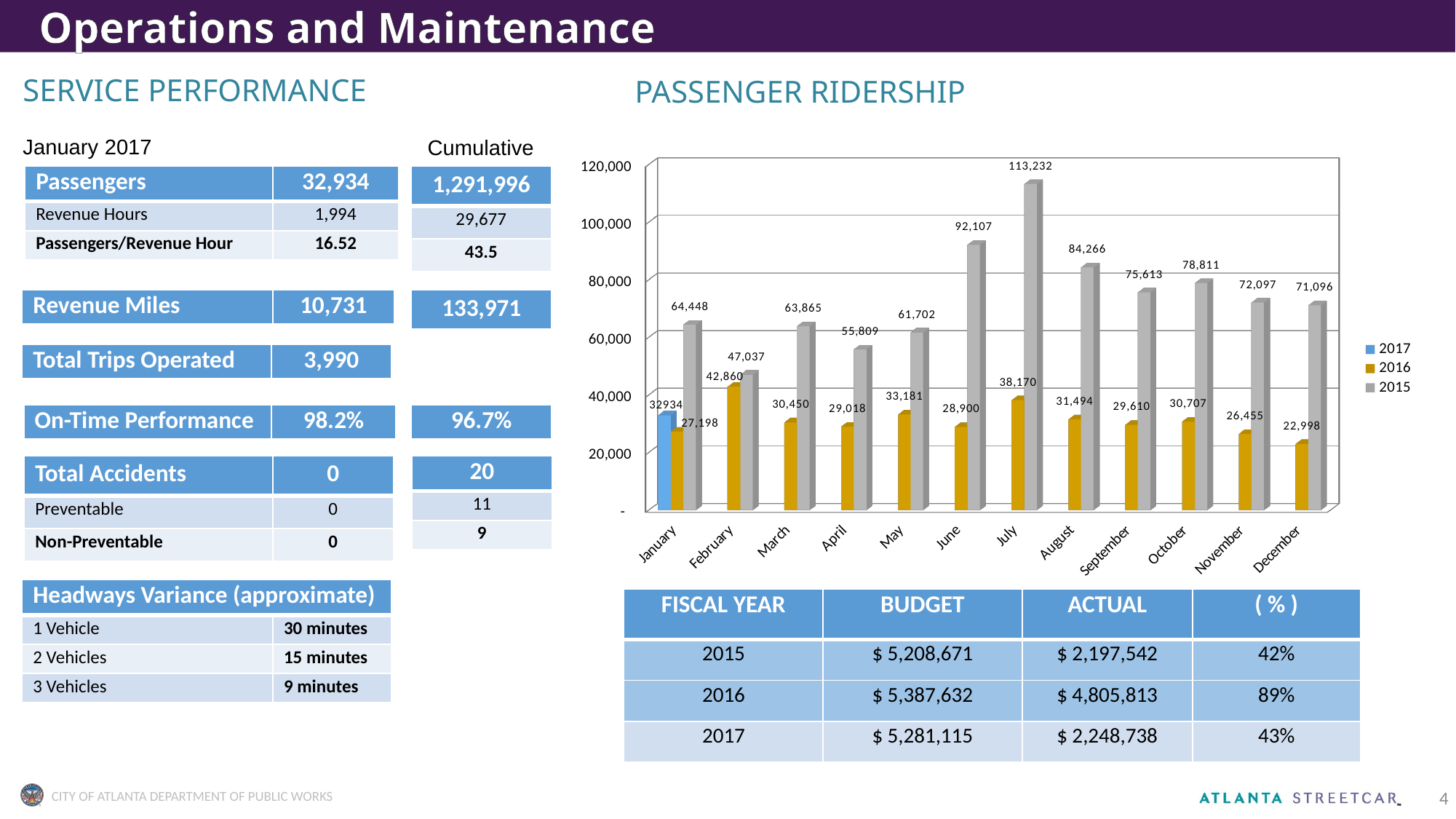
In the Passenger Ridership chart, what is the 2016 value for February? 42,860 In the Passenger Ridership chart, what is the 2015 value for July? 113,232 Which series in the Passenger Ridership chart is shown in gray? 2015 In the Passenger Ridership chart, what is the difference between the 2015 and 2016 values for June? 63,207 How many months are shown on the x axis of the Passenger Ridership chart? 12 What type of chart is shown under Passenger Ridership? bar chart How many series does the legend of the Passenger Ridership chart list? 3 In the Passenger Ridership chart, what is the 2017 value for January? 32934 In the Passenger Ridership chart, which month has the lowest 2016 value? December In the Passenger Ridership chart, which is larger: the 2016 value for July or the 2016 value for August? 2016 value for July In the Passenger Ridership chart, is the 2015 value for February greater or less than 40,000? greater In the Passenger Ridership chart, which month has the highest 2015 value? July